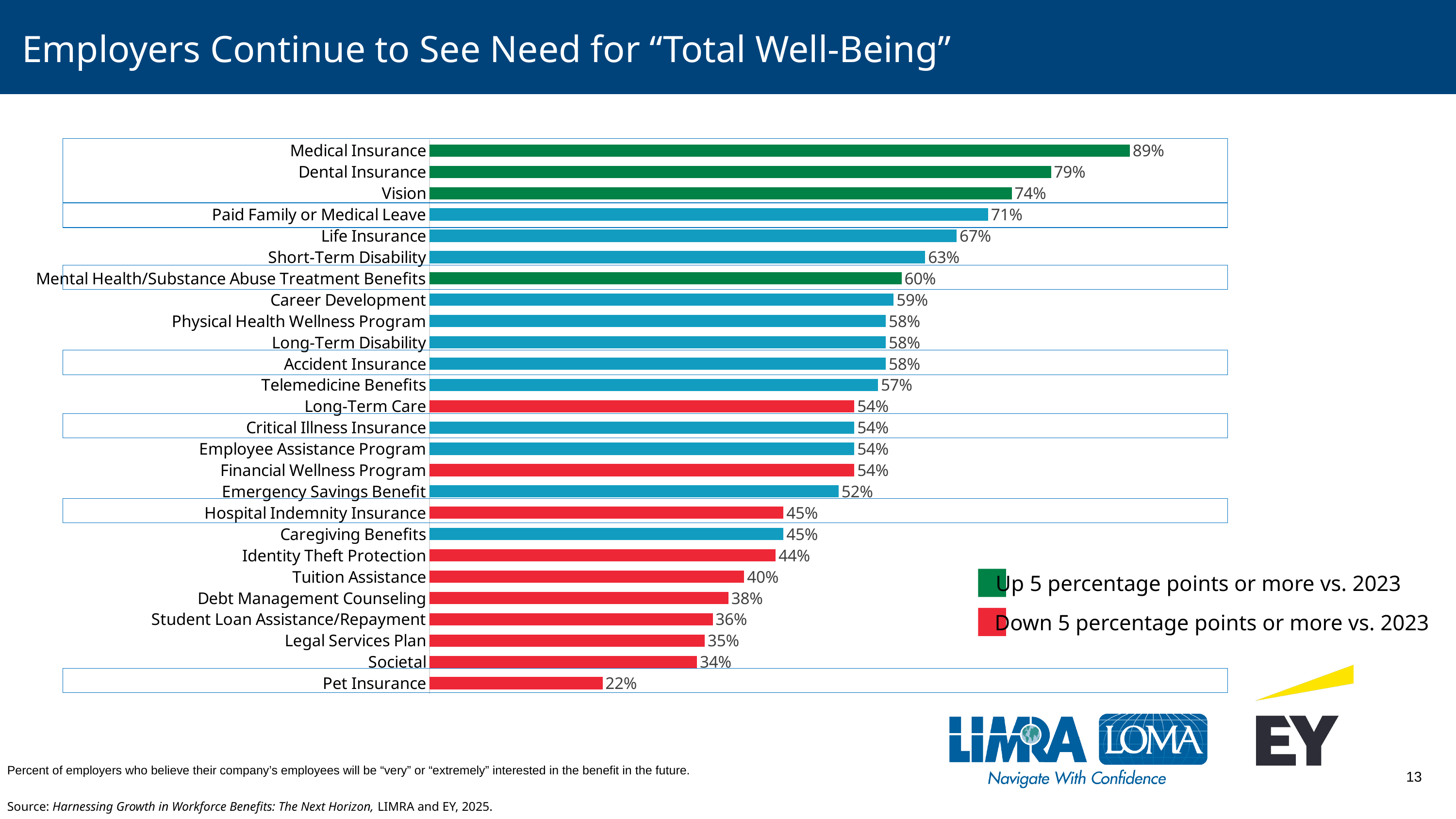
According to the legend, what does a green bar indicate? Up 5 percentage points or more vs. 2023 What is the value for Student Loan Assistance/Repayment? 36% Which category has the highest value? Medical Insurance What is the value for Mental Health/Substance Abuse Treatment Benefits? 60% Which is larger, the value for Life Insurance or the value for Career Development? Life Insurance What is the difference between the values for Medical Insurance and Dental Insurance? 10% What is the value for Medical Insurance? 89% Which category has the lowest value? Pet Insurance What is the difference between the values for Paid Family or Medical Leave and Pet Insurance? 49% What kind of chart is shown on the slide? Bar chart What is the value for Pet Insurance? 22% How many categories are shown in the chart? 26